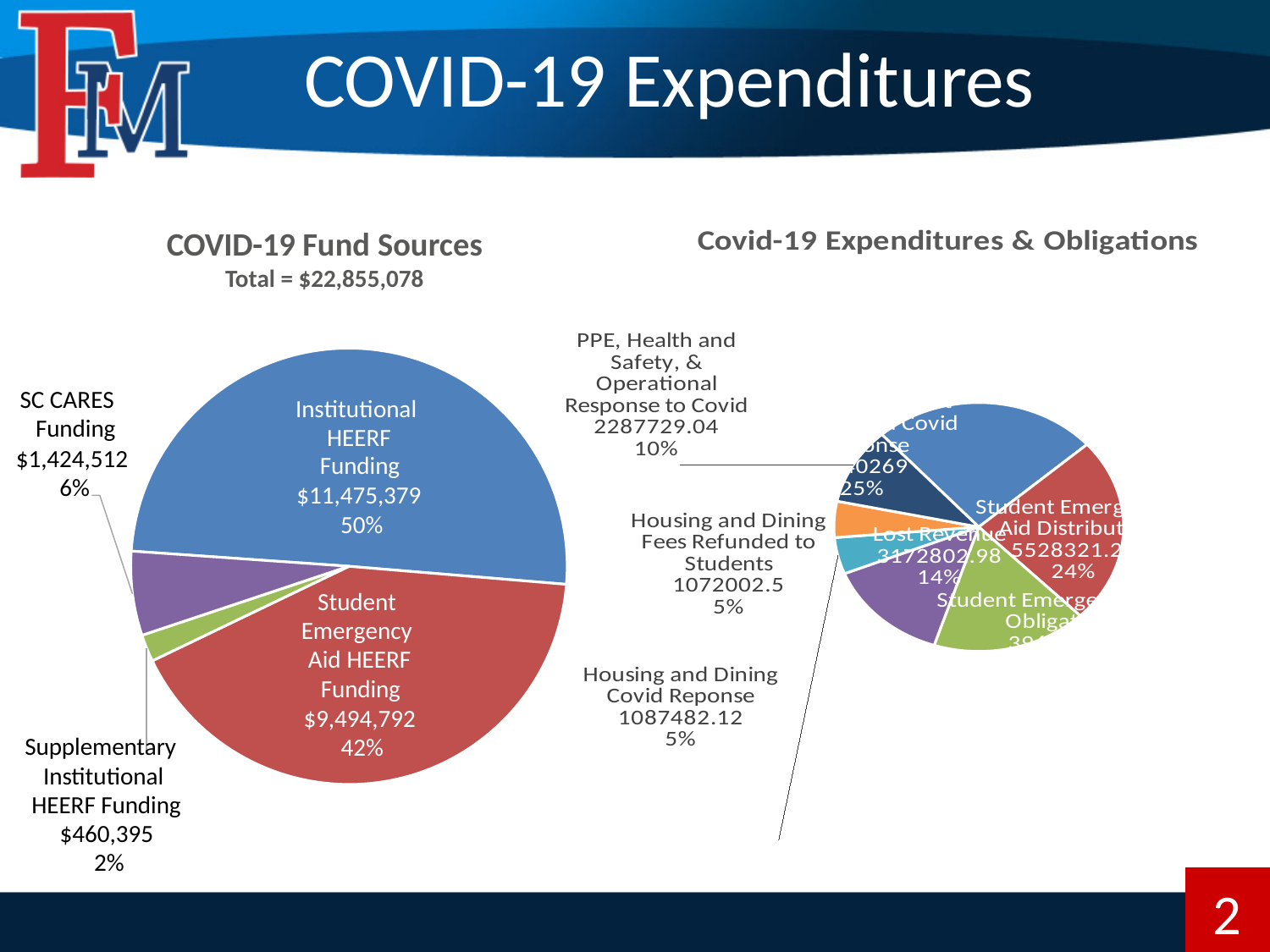
In the COVID-19 Fund Sources chart, what is the value for Student Emergency Aid HEERF Funding? $9,494,792 In the Covid-19 Expenditures & Obligations chart, what share of the pie is Lost Revenue? 14% In the COVID-19 Fund Sources chart, what share of the pie is Supplementary Institutional HEERF Funding? 2% In the COVID-19 Fund Sources chart, what is the value for Institutional HEERF Funding? $11,475,379 What kind of chart is the COVID-19 Fund Sources chart? pie chart In the COVID-19 Fund Sources chart, what is the value for SC CARES Funding? $1,424,512 In the Covid-19 Expenditures & Obligations chart, what is the value for PPE, Health and Safety, & Operational Response to Covid? 2287729.04 What total is shown under the COVID-19 Fund Sources chart title? $22,855,078 In the COVID-19 Fund Sources chart, which source is the largest? Institutional HEERF Funding In the COVID-19 Fund Sources chart, which source is the smallest? Supplementary Institutional HEERF Funding In the Covid-19 Expenditures & Obligations chart, which is larger: Housing and Dining Fees Refunded to Students or Lost Revenue? Lost Revenue How many slices does the COVID-19 Fund Sources pie chart have? 4